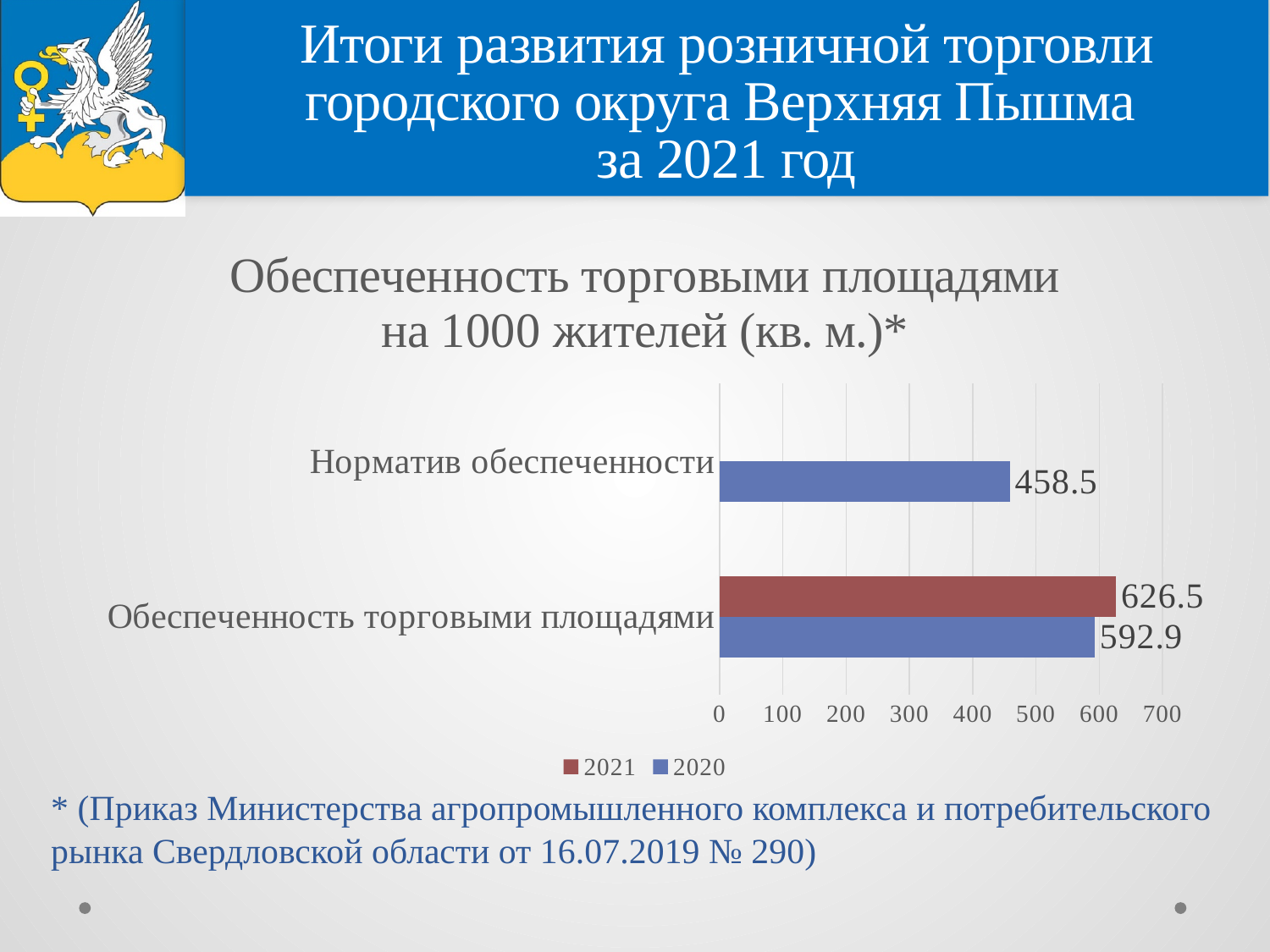
Which is larger: the 2021 value for "Обеспеченность торговыми площадями" or the "Норматив обеспеченности" value? 2021 value for Обеспеченность торговыми площадями What is the difference between the 2021 and 2020 values for "Обеспеченность торговыми площадями"? 33.6 Is the 2021 value for "Обеспеченность торговыми площадями" greater or less than 600? greater Which bar has the lowest value on the chart? Норматив обеспеченности Which bar has the highest value on the chart? Обеспеченность торговыми площадями (2021) How many series does the legend list? 2 What is the 2020 value for "Обеспеченность торговыми площадями"? 592.9 What is the 2021 value for "Обеспеченность торговыми площадями"? 626.5 What is the title of the chart? Обеспеченность торговыми площадями на 1000 жителей (кв. м.)* By how much does the 2020 value for "Обеспеченность торговыми площадями" exceed the "Норматив обеспеченности" value? 134.4 What kind of chart is shown on the slide? bar chart What is the value shown for "Норматив обеспеченности"? 458.5